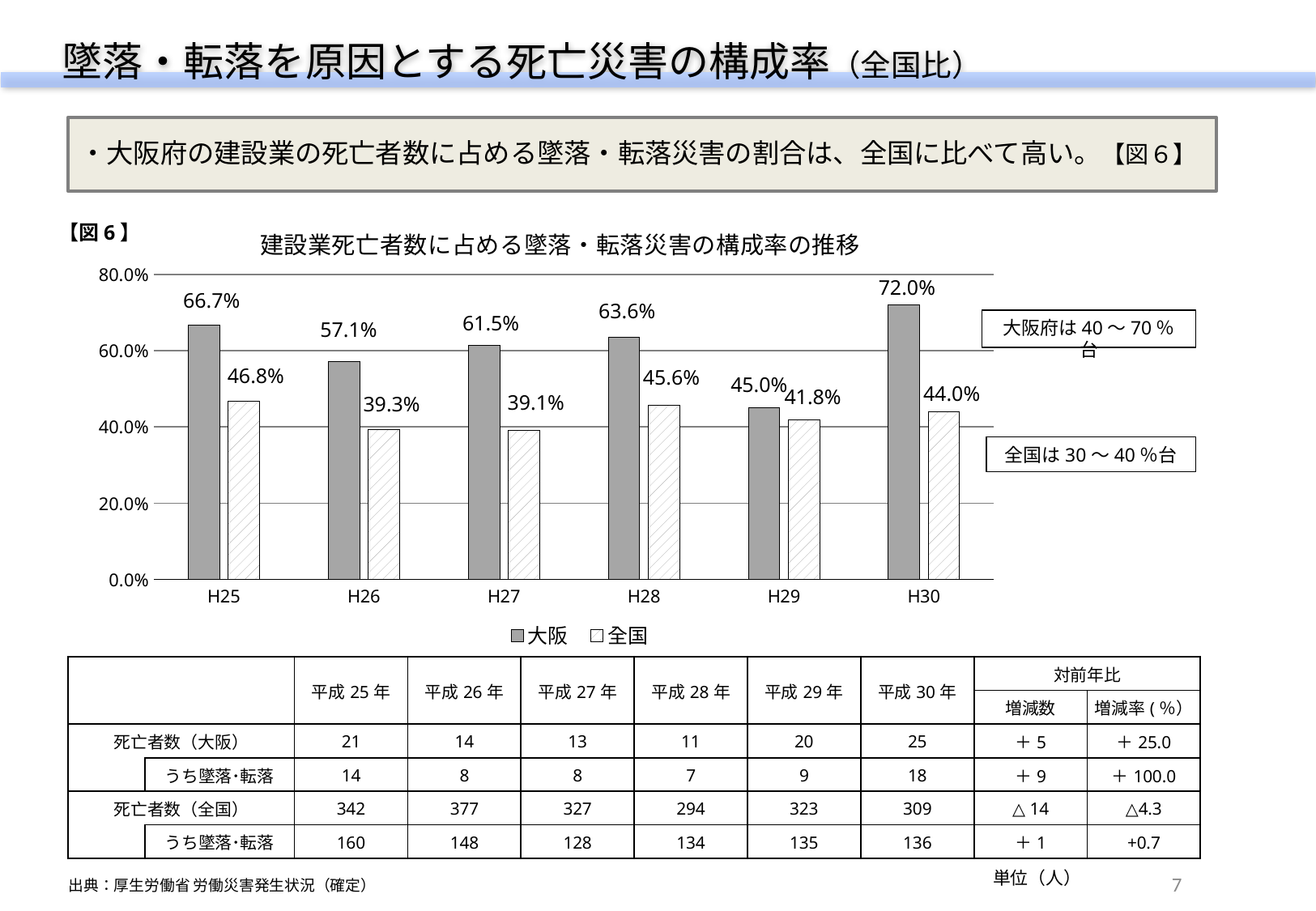
What is the value for 大阪 in H29? 45.0% What is the difference between the 大阪 and 全国 values in H26? 17.8% Which is larger in H28, the 大阪 value or the 全国 value? 大阪 How many years are shown on the x axis of the chart? 6 What kind of chart is shown on the slide? bar chart In which year is the 大阪 value highest? H30 What is the value for 大阪 in H30? 72.0% How many series does the chart legend list? 2 What is the title of the chart? 建設業死亡者数に占める墜落・転落災害の構成率の推移 What is the value for 全国 in H25? 46.8% In which year is the 全国 value lowest? H27 Does the 大阪 value rise or fall from H29 to H30? rise